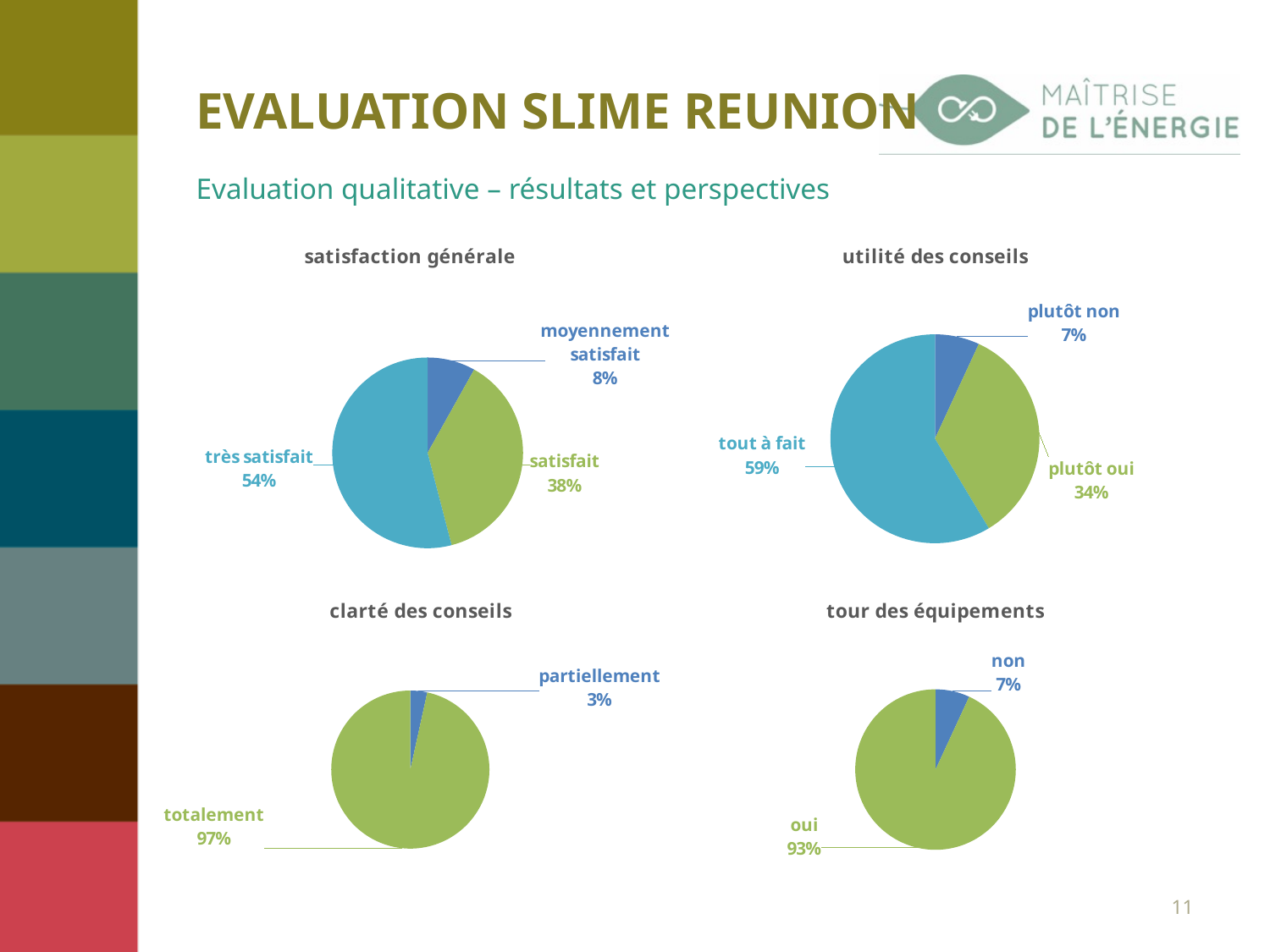
In the 'utilité des conseils' chart, which category has the largest share? tout à fait In the 'clarté des conseils' chart, what percentage is 'totalement'? 97% In the 'satisfaction générale' chart, what percentage is 'très satisfait'? 54% In the 'satisfaction générale' chart, which category has the smallest share? moyennement satisfait In the 'satisfaction générale' chart, what percentage is 'moyennement satisfait'? 8% How many charts are shown on the slide? 4 What kind of chart is the 'clarté des conseils' chart? pie chart In the 'utilité des conseils' chart, which is larger: 'plutôt oui' or 'plutôt non'? plutôt oui In the 'utilité des conseils' chart, what percentage is 'plutôt oui'? 34% How many categories does the 'satisfaction générale' chart have? 3 In the 'satisfaction générale' chart, what is the difference between 'très satisfait' and 'satisfait'? 16% In the 'tour des équipements' chart, what percentage is 'non'? 7%